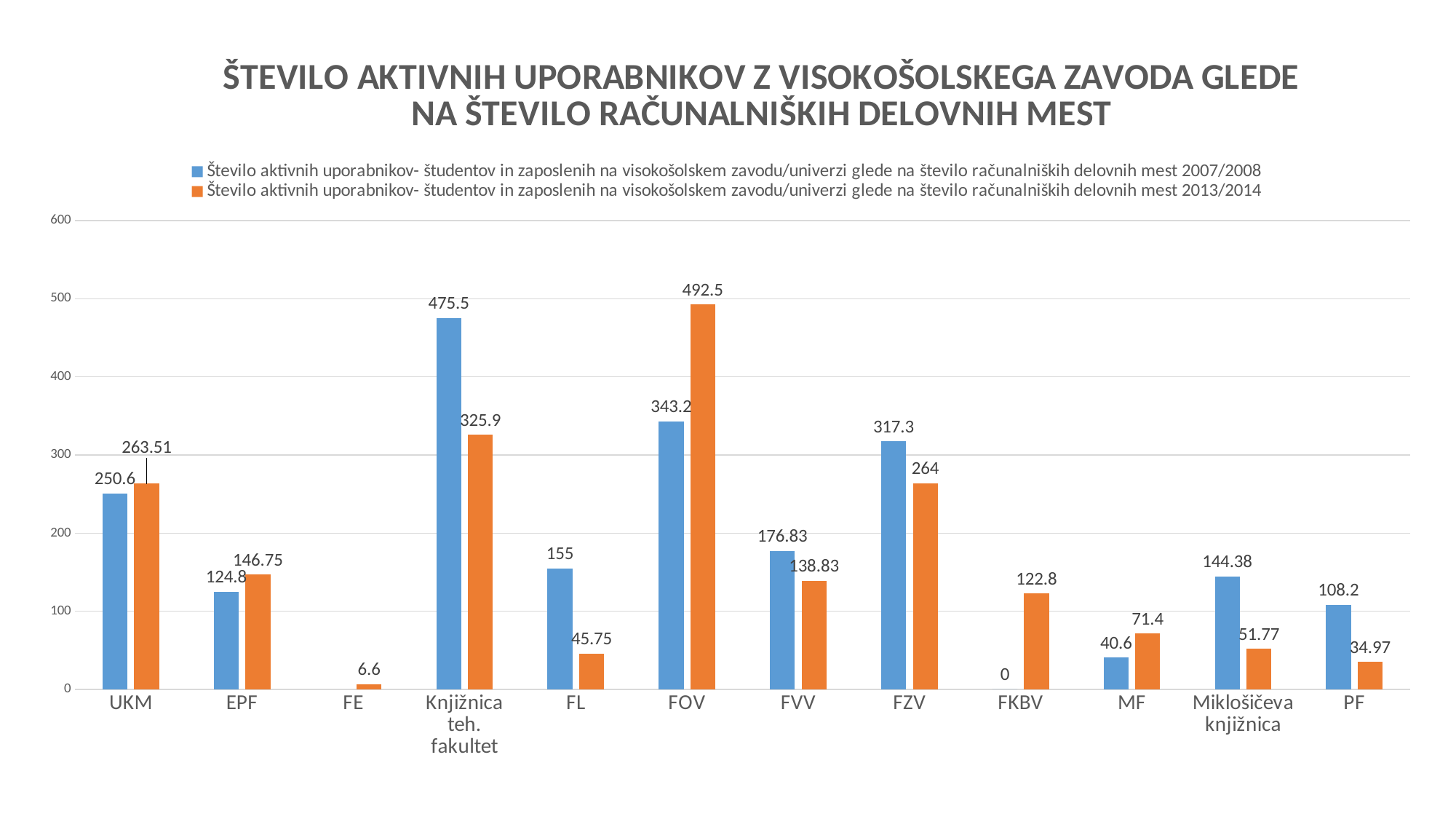
What is the value for MF in the 2013/2014 series? 71.4 What is the difference between the 2007/2008 and 2013/2014 values for FL? 109.25 What is the difference between the 2013/2014 and 2007/2008 values for FOV? 149.3 Which category has the highest value in the 2007/2008 series? Knjižnica teh. fakultet What is the value for FOV in the 2013/2014 series? 492.5 Which category has the lowest value in the 2013/2014 series? FE Which category has the highest value in the 2013/2014 series? FOV How many categories are shown on the x axis? 12 What is the value for FKBV in the 2007/2008 series? 0 For UKM, which series has the larger value, 2007/2008 or 2013/2014? 2013/2014 What is the value for Knjižnica teh. fakultet in the 2007/2008 series? 475.5 How many series does the legend list? 2